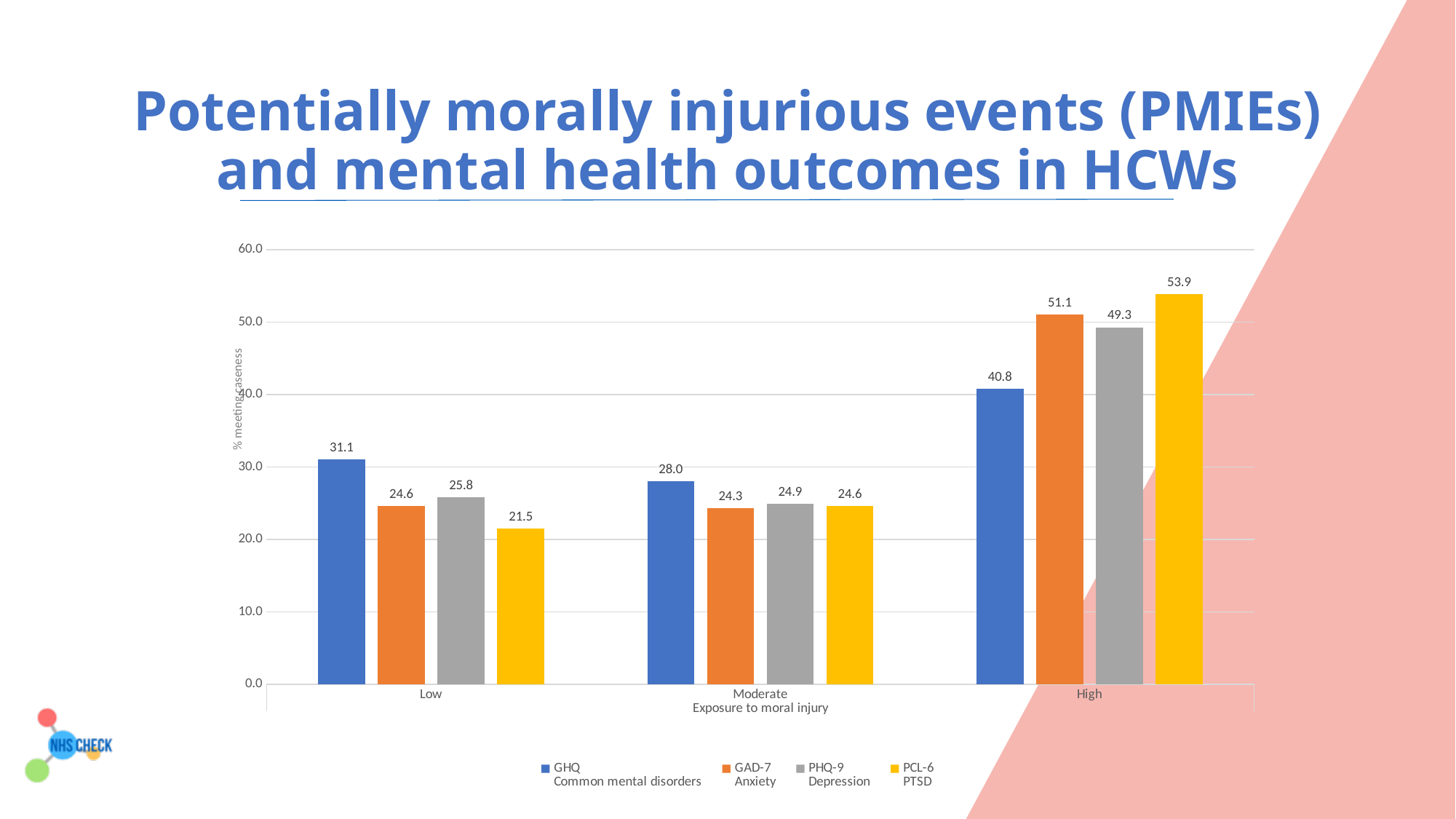
How many series does the legend list? 4 Which series has the highest value in the High exposure group? PCL-6 PTSD What is the difference between the PCL-6 PTSD values for the High and Low exposure groups? 32.4 Which is larger: PHQ-9 Depression in the Low group or PHQ-9 Depression in the High group? PHQ-9 Depression in the High group How many exposure categories are shown on the x axis? 3 What is the value for GAD-7 Anxiety in the Moderate exposure group? 24.3 What is the label of the y axis? % meeting caseness What is the value for GHQ Common mental disorders in the High exposure group? 40.8 What is the value for PCL-6 PTSD in the Low exposure group? 21.5 What kind of chart is shown on the slide? Bar chart Is the value for GAD-7 Anxiety in the High exposure group greater or less than 50.0? greater Which series has the lowest value in the Low exposure group? PCL-6 PTSD